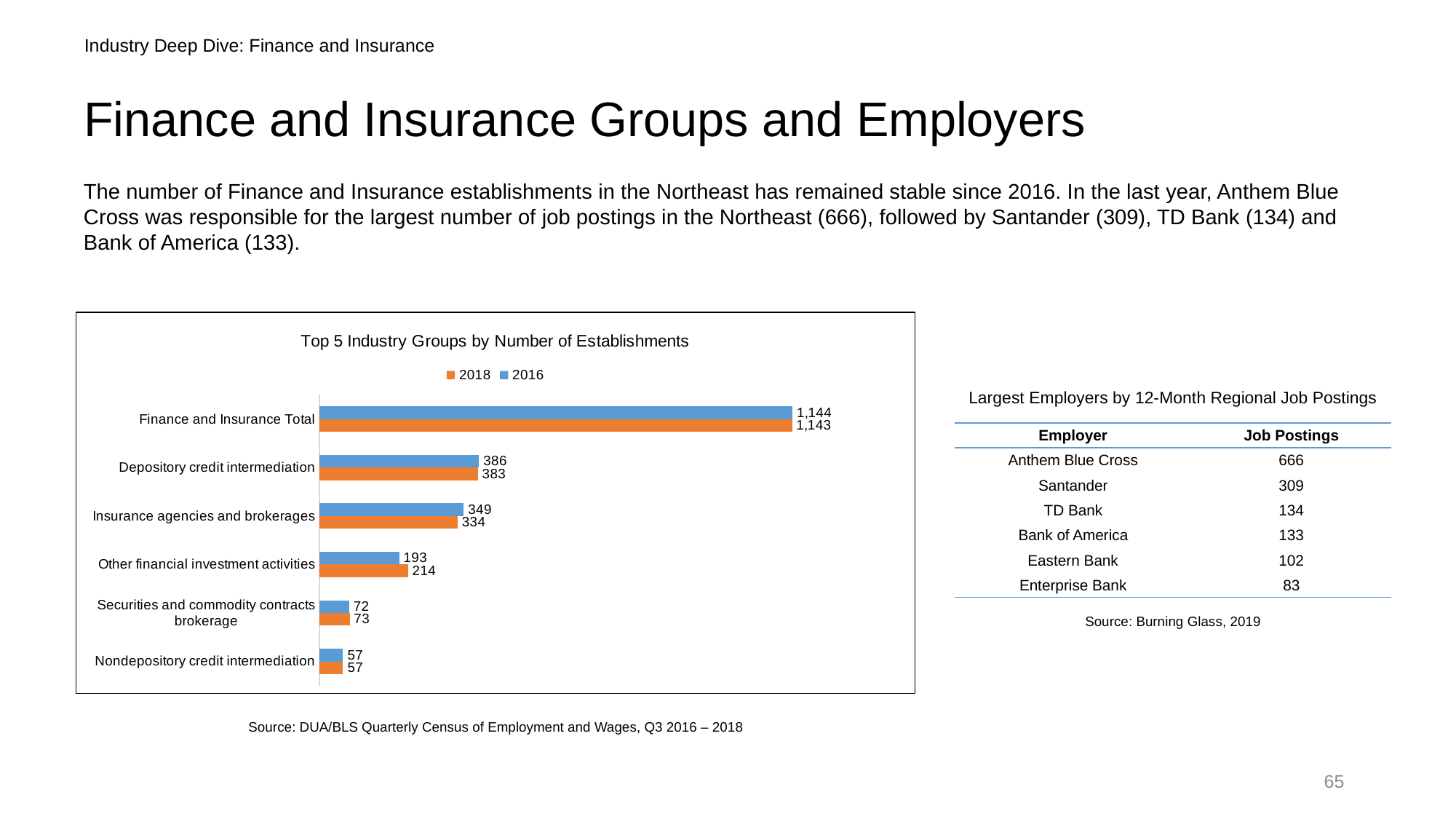
Excluding the Finance and Insurance Total, which industry group had the fewest establishments in 2018? Nondepository credit intermediation What is the difference between the 2016 and 2018 values for Insurance agencies and brokerages? 15 Which colour represents the 2018 series in the chart? Orange What was the number of establishments for Insurance agencies and brokerages in 2016? 349 How many categories are shown on the chart, including the Finance and Insurance Total? 6 Excluding the Finance and Insurance Total, which industry group had the most establishments in 2016? Depository credit intermediation For Other financial investment activities, was the number of establishments higher in 2016 or 2018? 2018 What was the number of establishments for Other financial investment activities in 2018? 214 How many series does the chart's legend list? 2 What was the Finance and Insurance Total number of establishments in 2016? 1,144 What was the number of establishments for Depository credit intermediation in 2018? 383 What type of chart is used to show the Top 5 Industry Groups by Number of Establishments? Bar chart